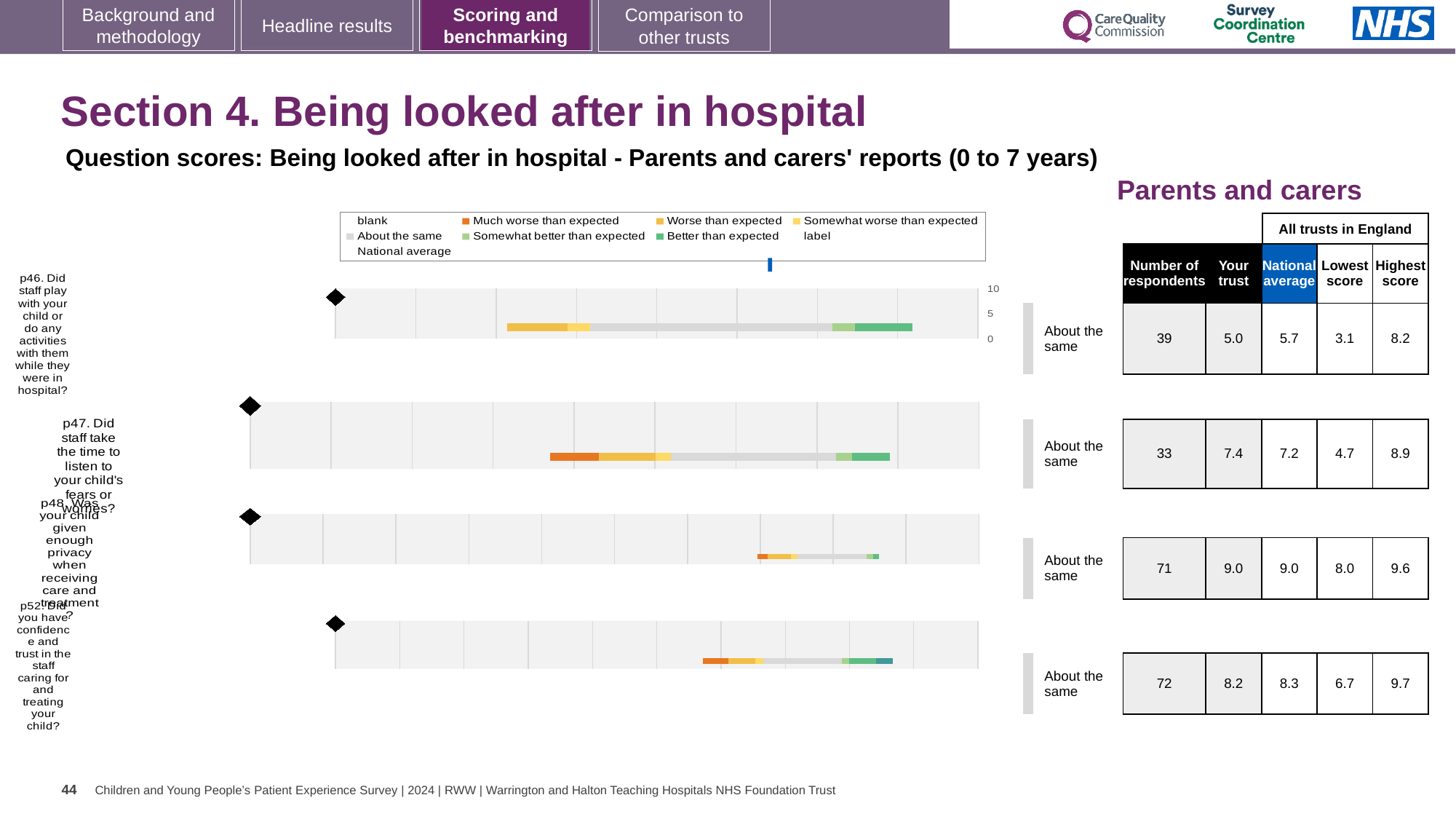
Which question has the lowest 'Your trust' score? p46 How many questions are plotted on the chart? 4 What is the 'Your trust' score for p46 (Did staff play with your child or do any activities with them while they were in hospital?)? 5.0 What is the national average score for p47 (Did staff take the time to listen to your child's fears or worries?)? 7.2 What kind of chart is used to show the question scores? Bar chart What benchmark category is shown for p46? About the same How many respondents answered p52 (Did you have confidence and trust in the staff caring for and treating your child?)? 72 For p47, which is larger: the 'Your trust' score or the national average? Your trust What is the highest score across all trusts in England for p48 (Was your child given enough privacy when receiving care and treatment?)? 9.6 For p52, what is the difference between the highest score and the lowest score across all trusts in England? 3.0 For p46, how much higher is the national average than the 'Your trust' score? 0.7 Which question has the highest 'Your trust' score? p48